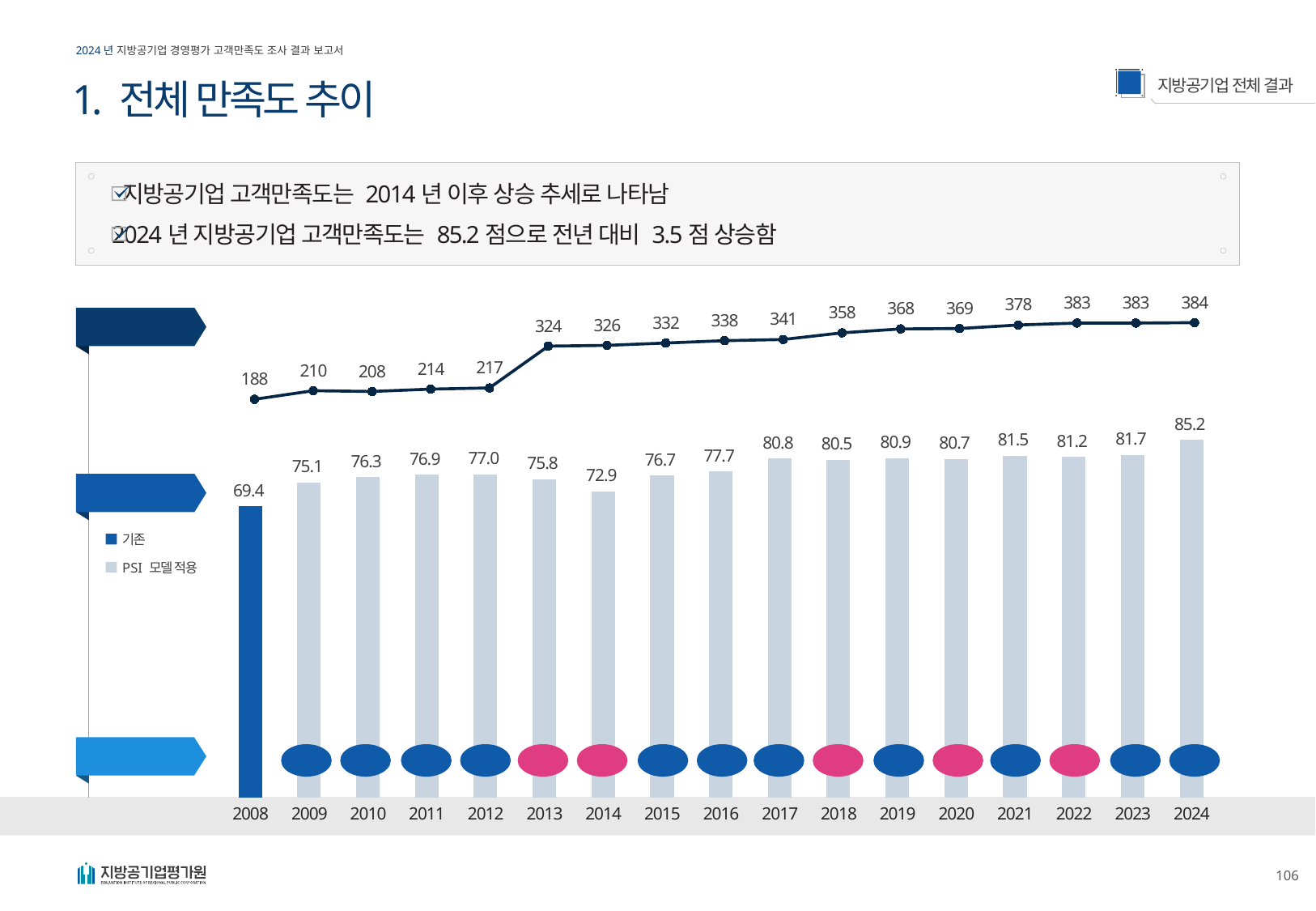
What is the difference between the line values for 2024 and 2008? 196 Do the line values generally rise or fall from 2008 to 2024? rise Which year has the larger bar value, 2014 or 2015? 2015 Which legend entry is shown in dark blue? 기존 Which year has the lowest bar value? 2008 Which year has the highest bar value? 2024 What is the difference between the bar values for 2024 and 2023? 3.5 What is the bar value for 2008? 69.4 How many entries does the legend list? 2 How many years are shown on the x axis? 17 What is the line value shown above the 2013 bar? 324 What is the bar value for 2024? 85.2